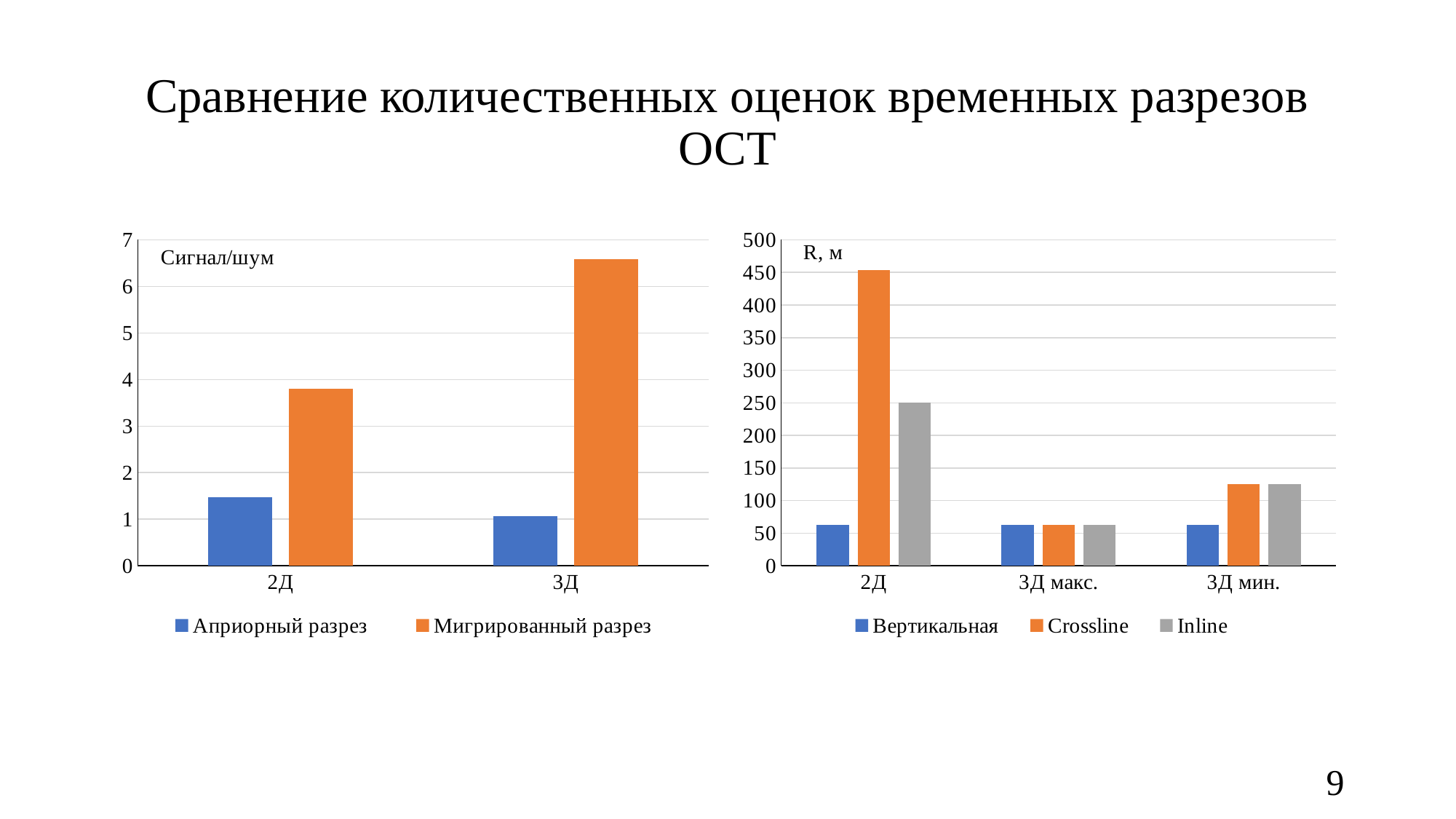
In the left chart (Сигнал/шум), is the value for Априорный разрез at 2Д greater or less than 2? less In the left chart (Сигнал/шум), which category has the higher value for Мигрированный разрез, 2Д or 3Д? 3Д In the left chart (Сигнал/шум), which series has the higher value at 2Д? Мигрированный разрез How many series does the legend of the right chart (R, м) list? 3 In the right chart (R, м), which is larger at 3Д мин., Crossline or Вертикальная? Crossline How many series does the legend of the left chart (Сигнал/шум) list? 2 In the left chart (Сигнал/шум), is the value for Мигрированный разрез at 3Д greater or less than 6? greater How many categories are shown on the x axis of the right chart (R, м)? 3 In the right chart (R, м), which series and category has the tallest bar? Crossline at 2Д In the right chart (R, м), is the value for Crossline at 2Д greater or less than 400? greater What kind of chart is the left chart (Сигнал/шум)? bar chart